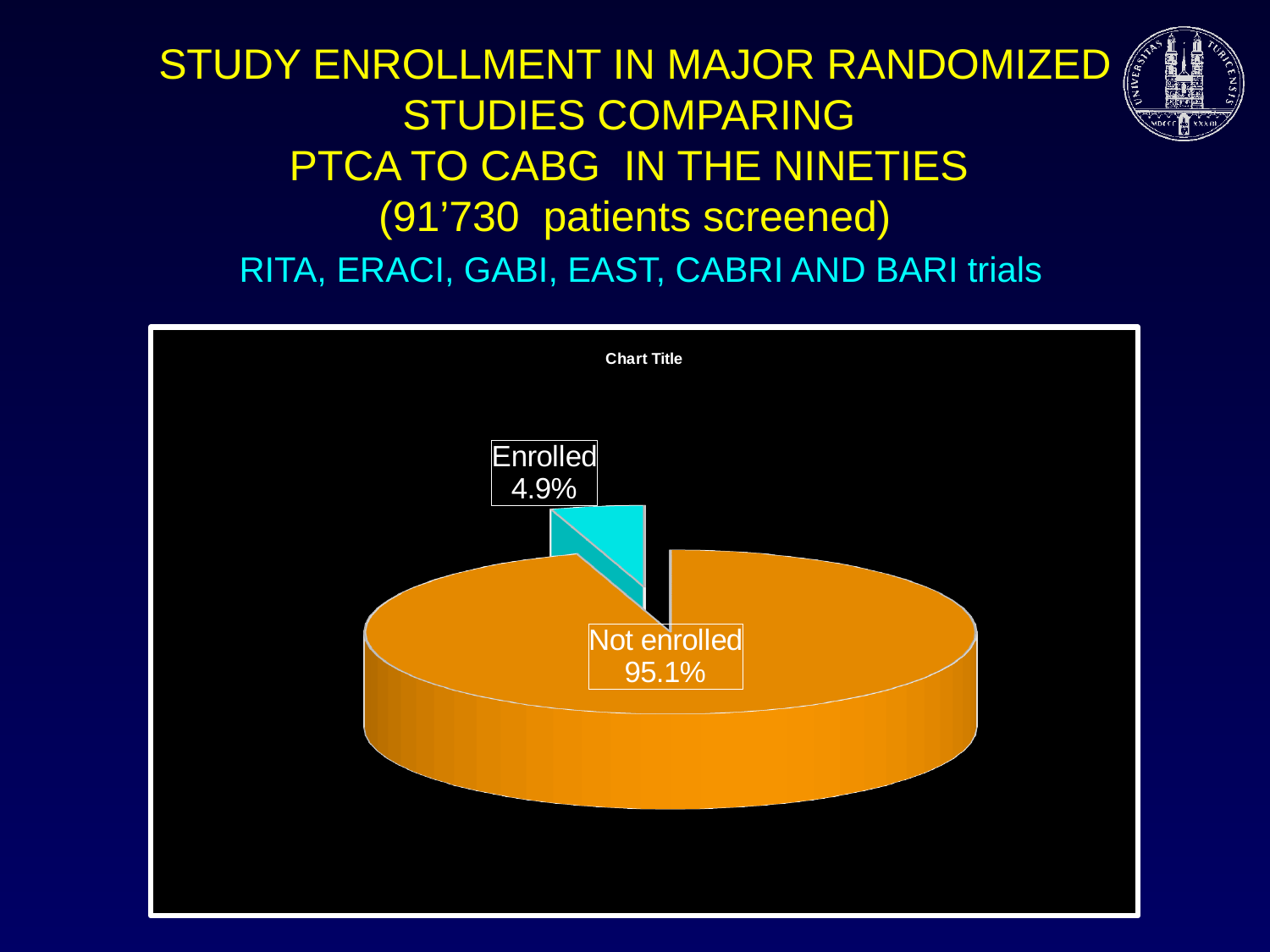
What colour is the Enrolled slice? cyan What share of the pie is labelled Not enrolled? 95.1% What is the total of the two slice percentages shown? 100% Which slice of the pie is the largest? Not enrolled Which slice of the pie is the smallest? Enrolled What share of the pie is labelled Enrolled? 4.9% What kind of chart is shown on the slide? pie chart What is the title printed above the pie chart? Chart Title How many slices does the pie chart have? 2 What is the difference in percentage points between the Not enrolled and Enrolled slices? 90.2 Which is larger, the Enrolled slice or the Not enrolled slice? Not enrolled